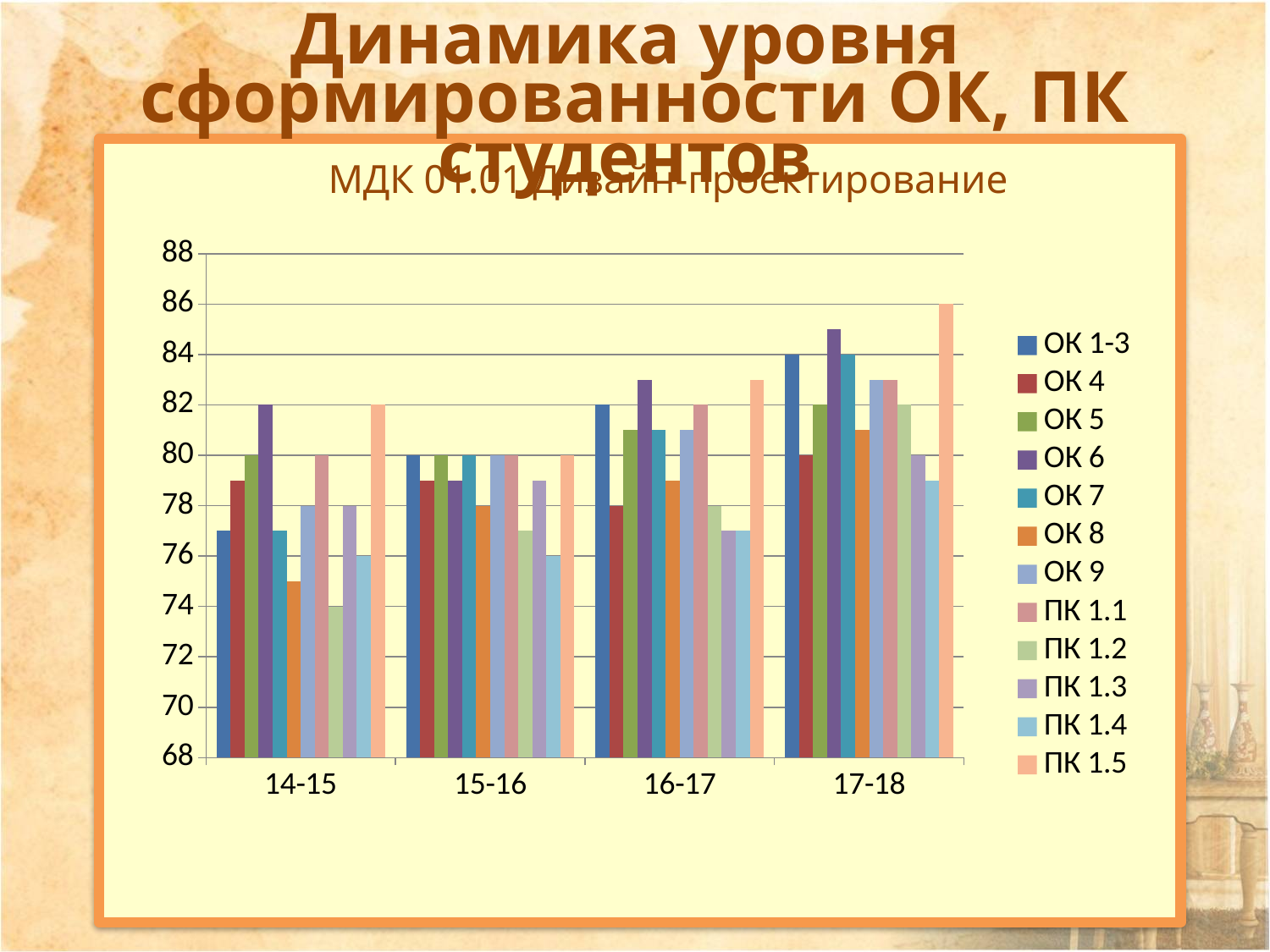
Which series has the lowest value in the 14-15 group? ПК 1.2 What kind of chart is shown on the slide? bar chart What is the value of ПК 1.2 in the 14-15 group? 74 Is the value for ОК 1-3 in 14-15 greater or less than 78? less What is the value of ПК 1.5 in the 17-18 group? 86 Is the value for ОК 6 in 17-18 greater or less than 84? greater Which series has the lowest value in the 15-16 group? ПК 1.4 What is the title printed above the chart? МДК 01.01 Дизайн-проектирование How many series does the legend list? 12 How many year categories are shown on the x axis? 4 Which series has the highest value in the 17-18 group? ПК 1.5 Does the value of ОК 1-3 rise or fall from 14-15 to 17-18? rise